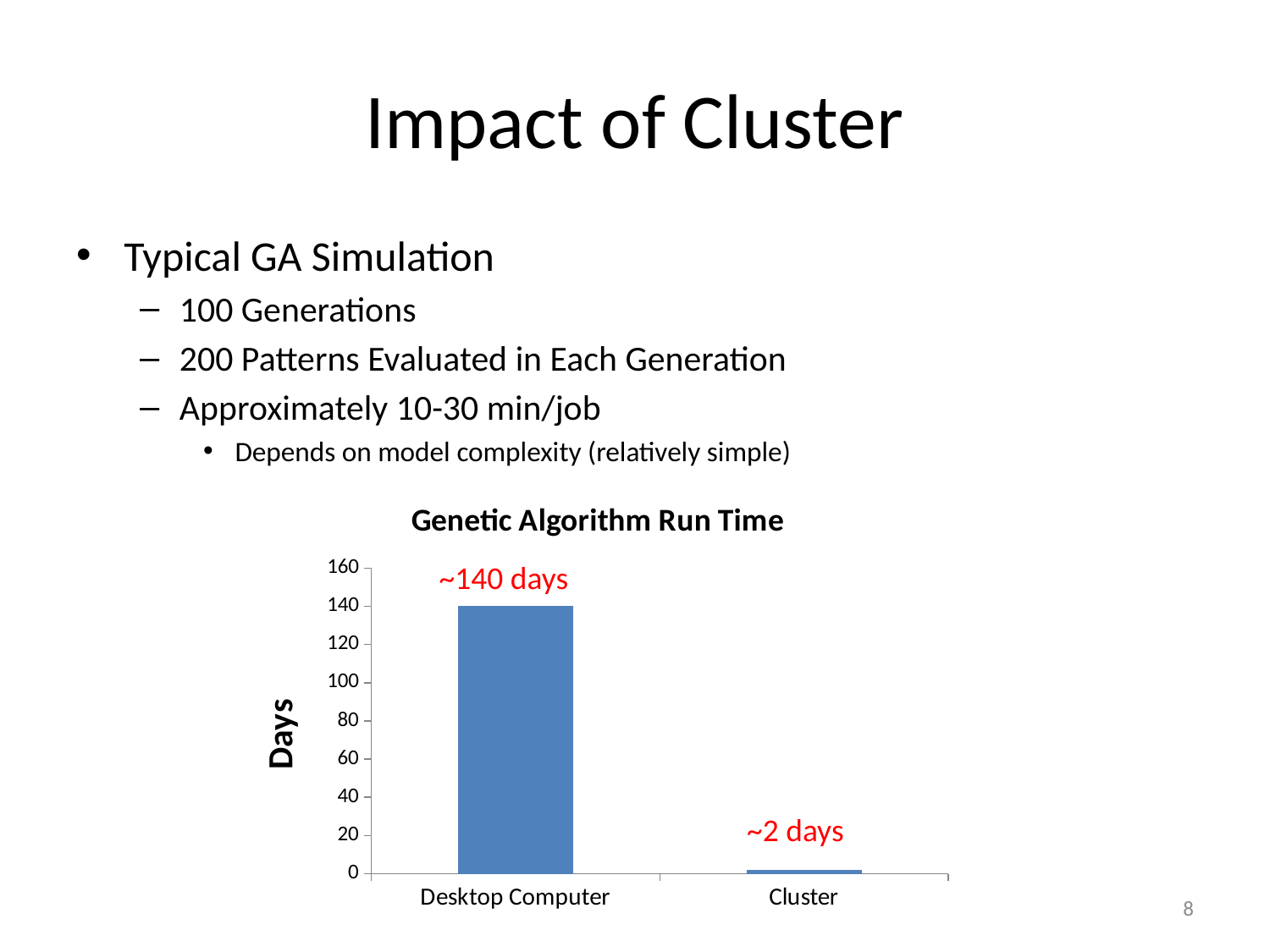
What is the label on the y axis of the chart? Days Which is larger, the value for Desktop Computer or the value for Cluster? Desktop Computer Do the values rise or fall from Desktop Computer to Cluster along the x axis? fall Is the value for Cluster greater or less than 20? less Is the value for Desktop Computer greater or less than 160? less What type of chart is shown on the slide? bar chart Is the value for Desktop Computer greater or less than 120? greater How many categories are shown on the x axis of the chart? 2 Which category has the highest value in the chart? Desktop Computer What is the title of the chart? Genetic Algorithm Run Time Which category has the lowest value in the chart? Cluster